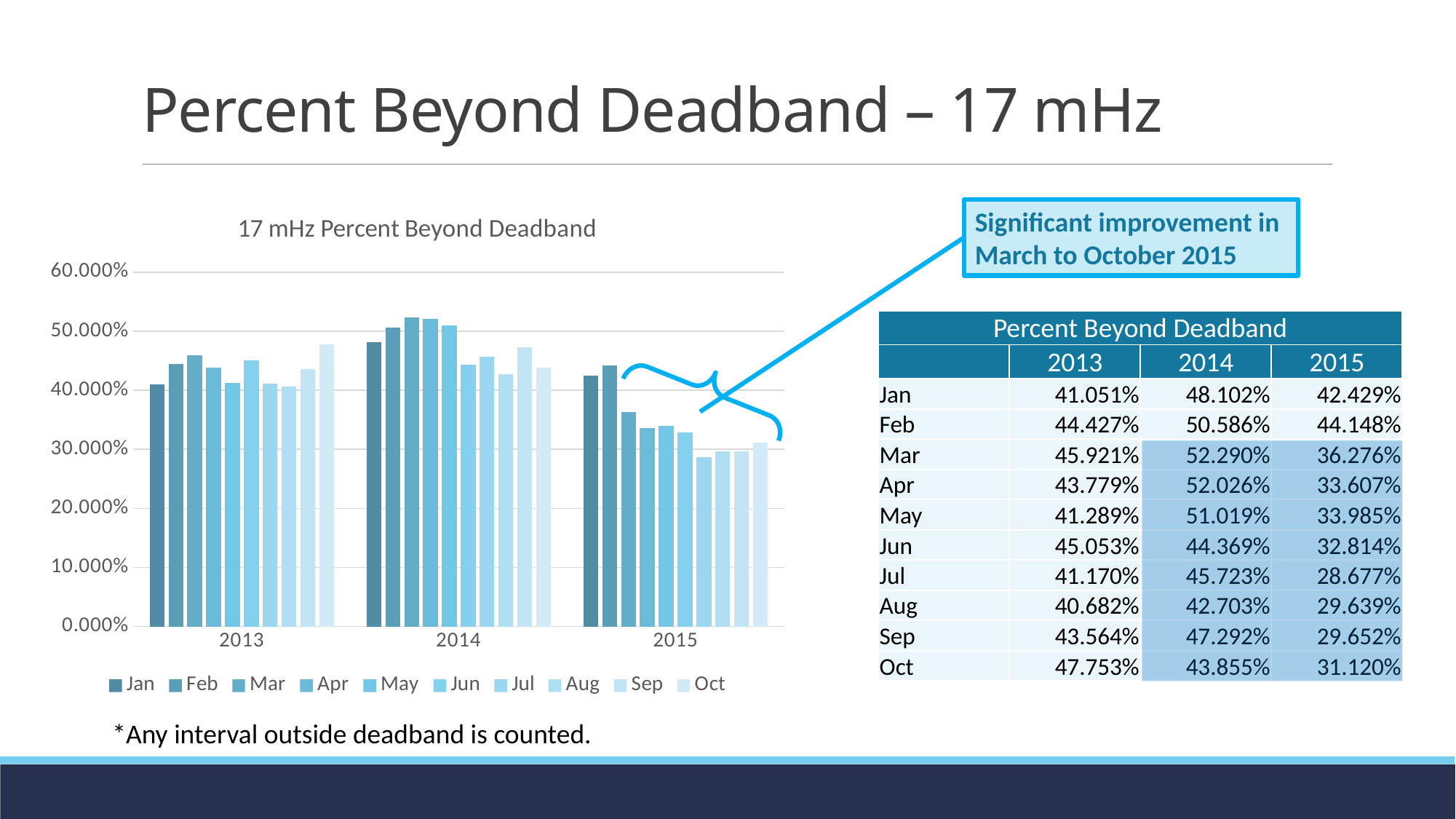
What is the title of the chart? 17 mHz Percent Beyond Deadband How many series does the chart legend list? 10 What is the difference between the Mar values for 2014 and 2015? 16.014% Which month has the lowest value in 2015? Jul Which is larger, the value for Jan in 2014 or the value for Jan in 2015? Jan in 2014 What type of chart is shown on the slide? bar chart How many year categories are shown on the x axis of the chart? 3 What is the value for Mar in 2014? 52.290% Which month has the highest value in 2013? Oct What is the value for Jul in 2015? 28.677% Is the value for Mar in 2014 greater or less than 50.000%? greater Which month has the highest value in 2014? Mar